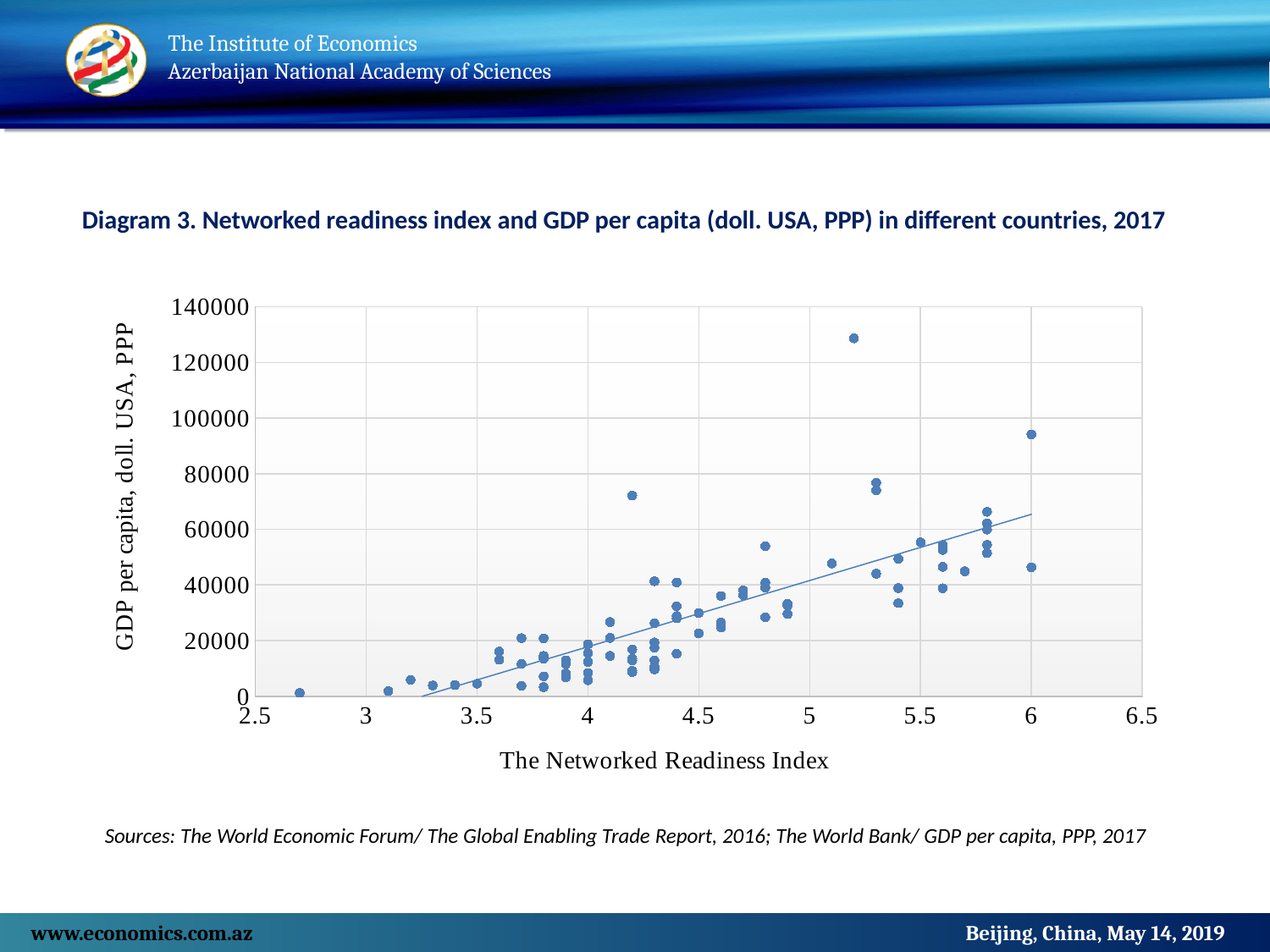
Is the GDP per capita of the lowest point on the chart, at a Networked Readiness Index of about 2.7, greater or less than 20000? less What is the maximum value shown on the vertical axis? 140000 What is the label of the horizontal axis? The Networked Readiness Index What kind of chart is shown on the slide? Scatter chart What is the title of the chart? Diagram 3. Networked readiness index and GDP per capita (doll. USA, PPP) in different countries, 2017 Is the highest GDP per capita value plotted at a Networked Readiness Index of 6 greater or less than 80000? greater Overall, does GDP per capita tend to rise or fall as the Networked Readiness Index increases? Rise Which has the higher GDP per capita: the topmost point at a Networked Readiness Index of 6 or the topmost point at about 5.3? The point at 6